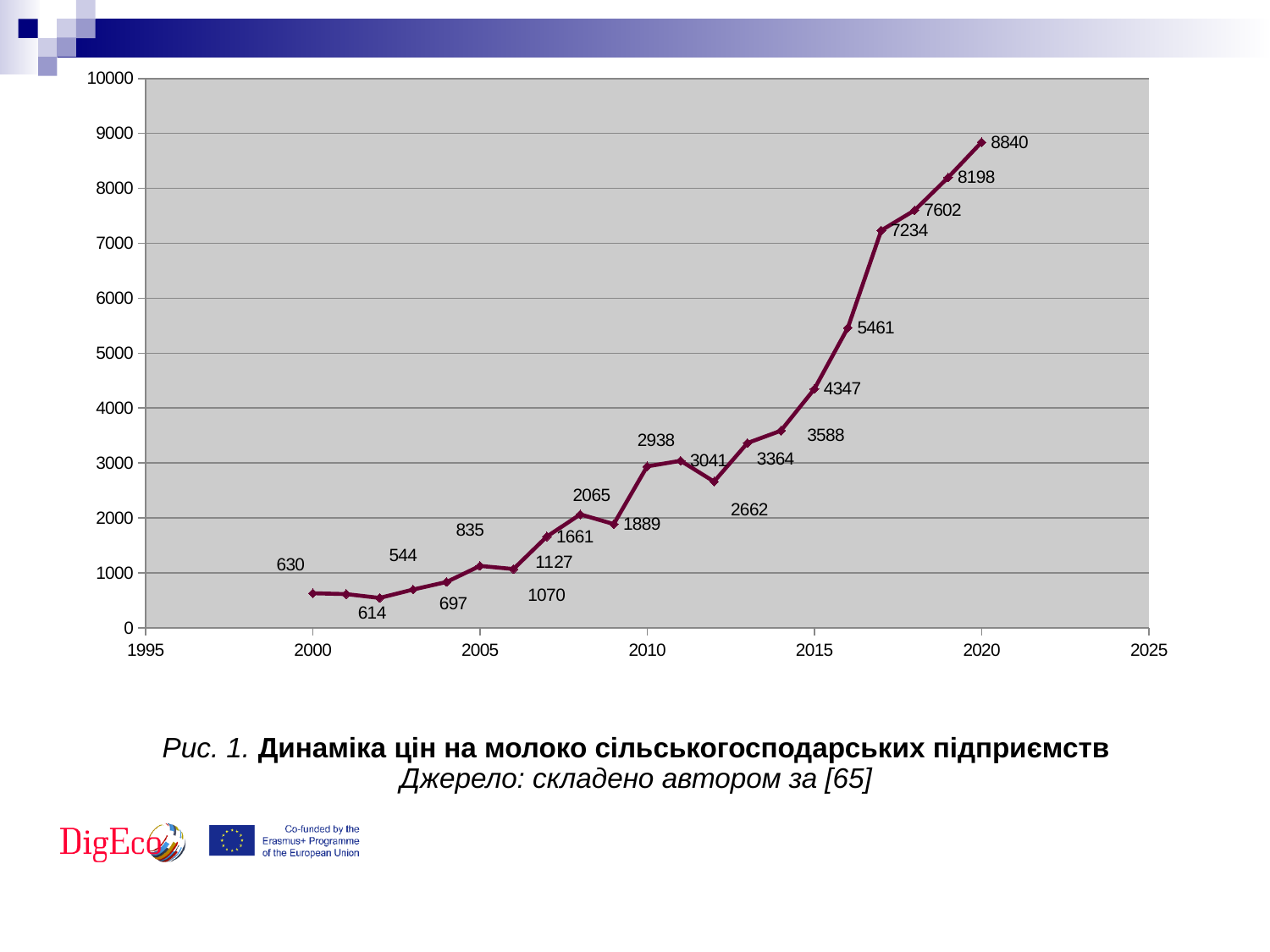
What is the highest value shown on the chart? 8840 Is the value for 2016 greater or less than 5000? greater What is the lowest value shown on the chart? 544 What is the value plotted for the year 2000? 630 What is the caption (figure title) given below the chart? Рис. 1. Динаміка цін на молоко сільськогосподарських підприємств What kind of chart is shown on the slide? line chart What is the value plotted for the year 2010? 2938 Overall, do the values rise or fall from 2000 to 2020? rise What is the value plotted for the year 2015? 4347 What is the value plotted for the year 2020? 8840 What is the difference between the value for 2020 and the value for 2000? 8210 Which is larger, the value for 2011 or the value for 2012? 2011